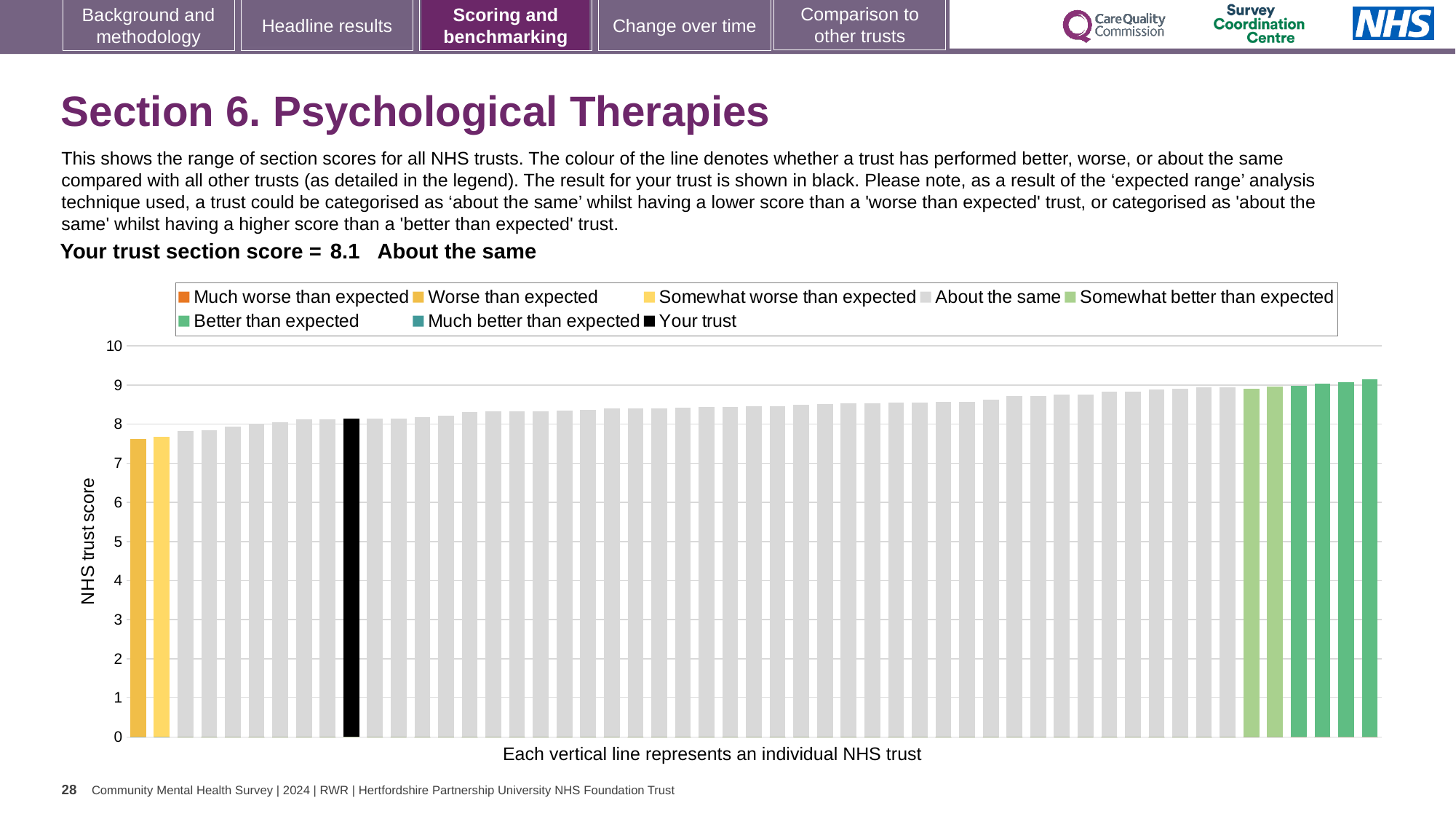
Is the value for the lowest-scoring trust (leftmost bar) greater or less than 8? less Which bar is taller, the leftmost bar or the rightmost bar? the rightmost bar Is the value for your trust greater or less than 8? greater What kind of chart is shown on the slide? bar chart How many bars are coloured black (Your trust)? 1 Do the trust scores rise or fall moving from left to right along the x axis? rise How many bars are coloured yellow (Worse than expected)? 1 What colour is the bar representing your trust? black What is the section score for your trust shown on the slide? 8.1 How many entries does the chart legend list? 8 What is the label on the vertical axis of the chart? NHS trust score How is your trust's performance categorised relative to other trusts? About the same